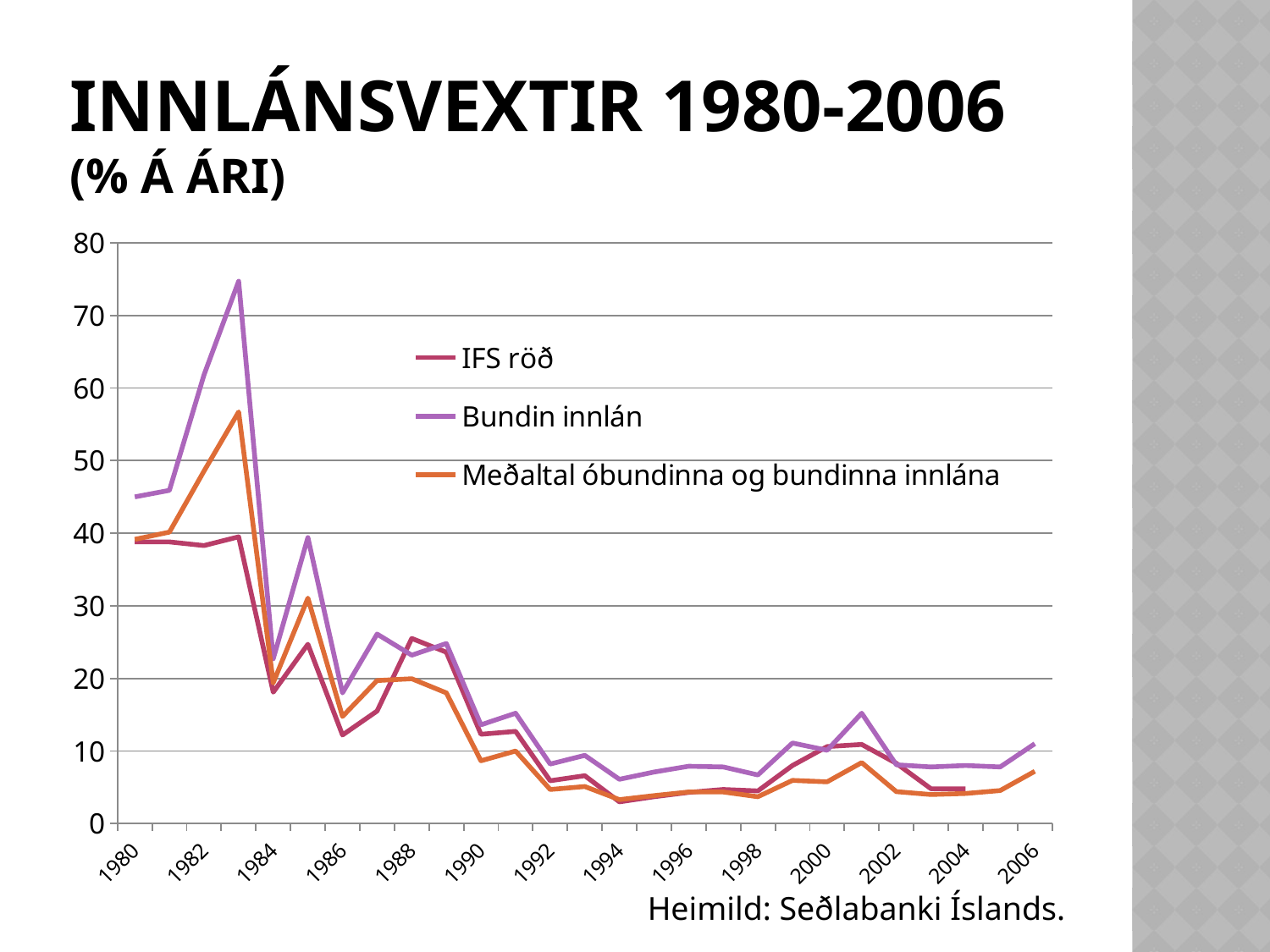
In 1980, which series is higher, Bundin innlán or Meðaltal óbundinna og bundinna innlána? Bundin innlán In 1983, which series is higher, Bundin innlán or IFS röð? Bundin innlán What are the three series named in the legend? IFS röð, Bundin innlán, Meðaltal óbundinna og bundinna innlána Is the value for Bundin innlán in 2006 greater or less than 20? less What is the title of the chart? INNLÁNSVEXTIR 1980-2006 (% Á ÁRI) Is the value for Meðaltal óbundinna og bundinna innlána in 1983 greater or less than 50? greater Is the value for Bundin innlán in 1983 greater or less than 70? greater What kind of chart is shown on the slide? line chart In which year does the Bundin innlán series reach its highest value? 1983 How many series does the legend list? 3 Overall, do the interest rates rise or fall from 1980 to 2006? fall